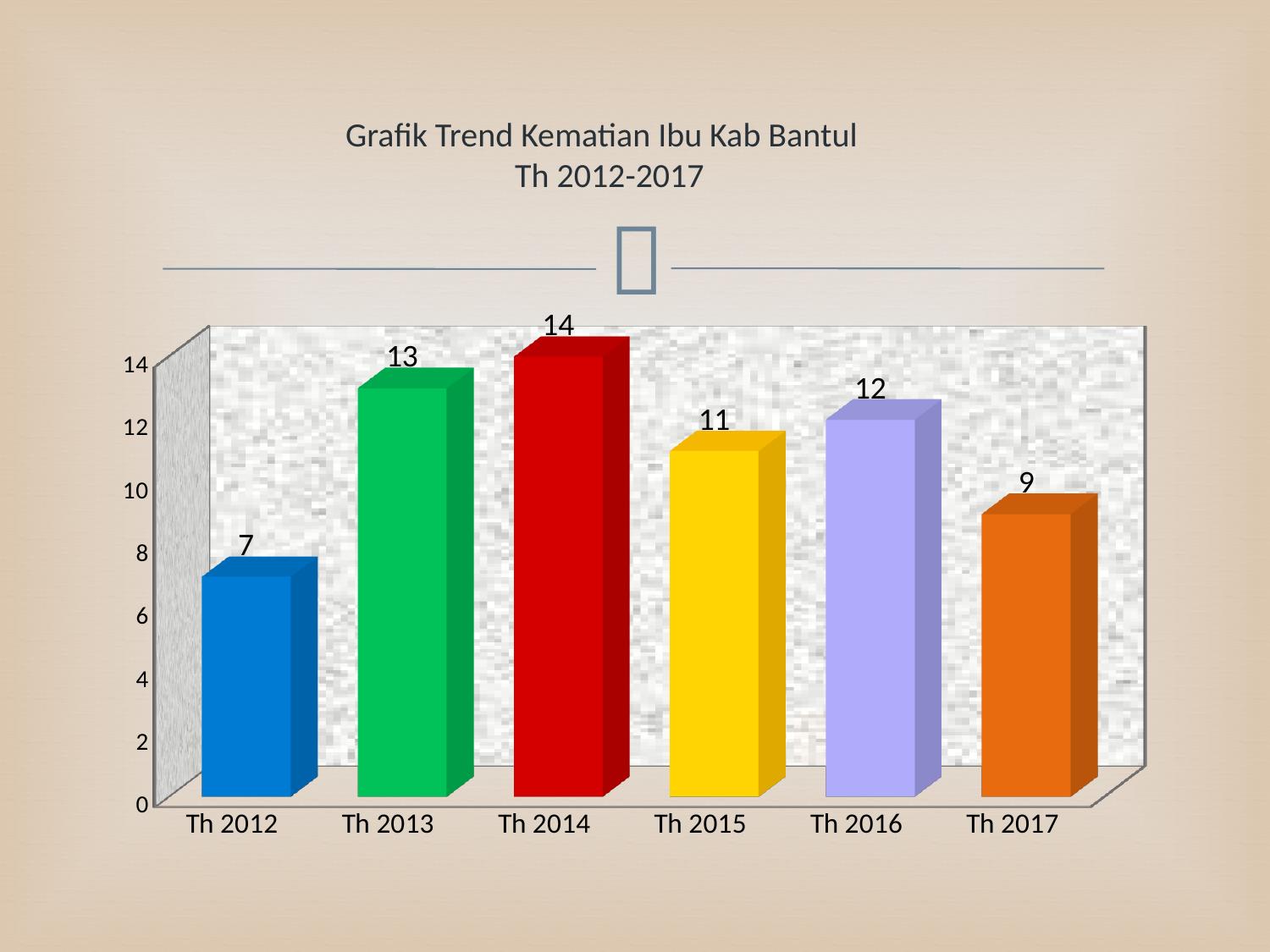
How many years are shown on the x axis? 6 What is the title of the chart? Grafik Trend Kematian Ibu Kab Bantul Th 2012-2017 Which is larger, the value for Th 2013 or the value for Th 2016? Th 2013 What is the difference between the values for Th 2016 and Th 2017? 3 What is the value for Th 2015? 11 Which year has the highest value? Th 2014 What kind of chart is shown on the slide? bar chart Which year has the lowest value? Th 2012 Is the value for Th 2015 greater or less than 10? greater What is the value for Th 2012? 7 What is the difference between the values for Th 2014 and Th 2012? 7 What is the value for Th 2017? 9